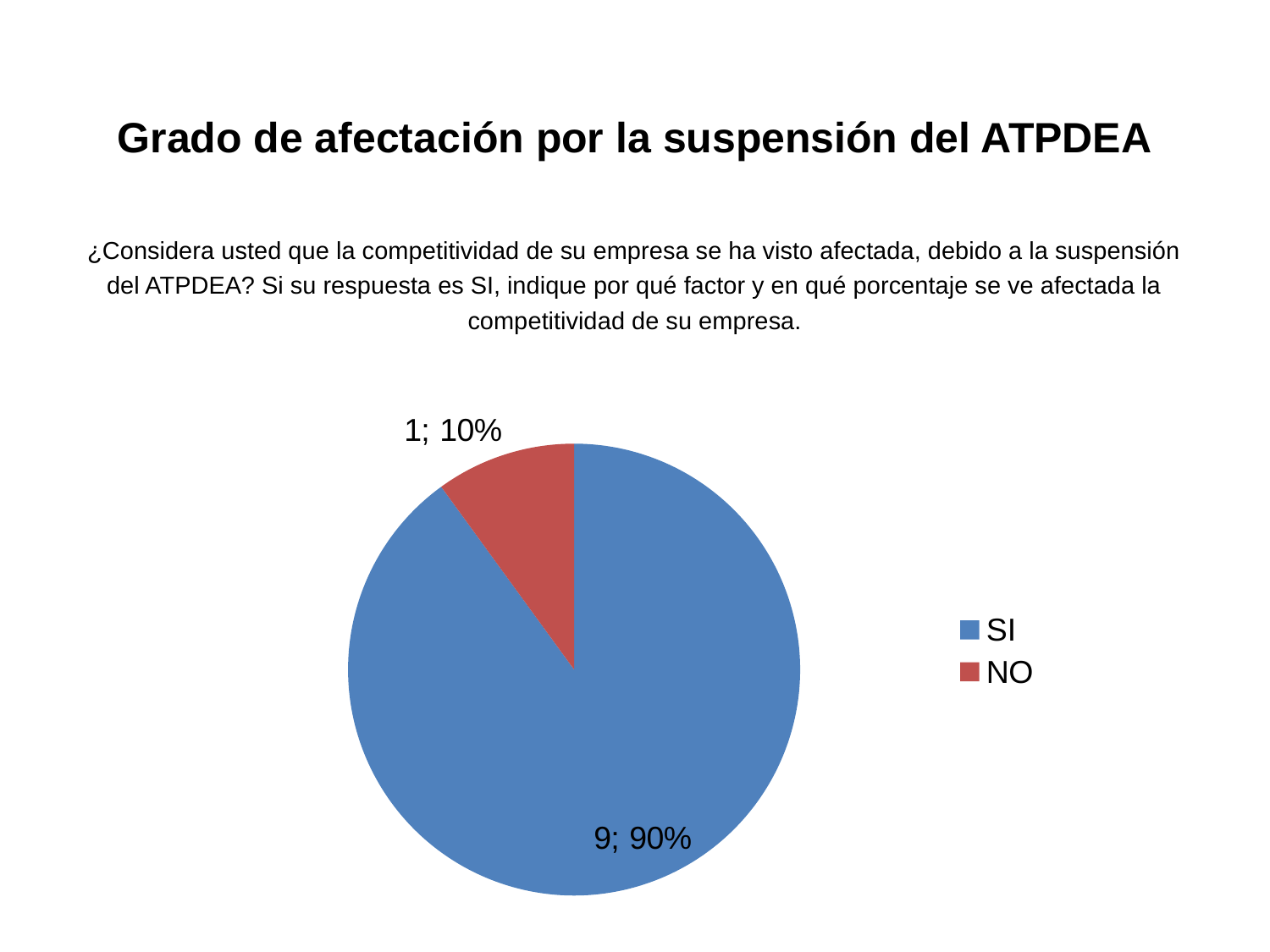
What kind of chart is shown on the slide? pie chart Which category has the largest slice? SI Which is larger, the SI slice or the NO slice? SI What share of the pie does the SI slice represent? 90% Which category has the smallest slice? NO What is the count for the SI slice? 9 What share of the pie does the NO slice represent? 10% How many entries does the legend list? 2 What is the count for the NO slice? 1 What colour is the NO slice? red What is the difference between the counts for SI and NO? 8 How many slices does the pie chart have? 2